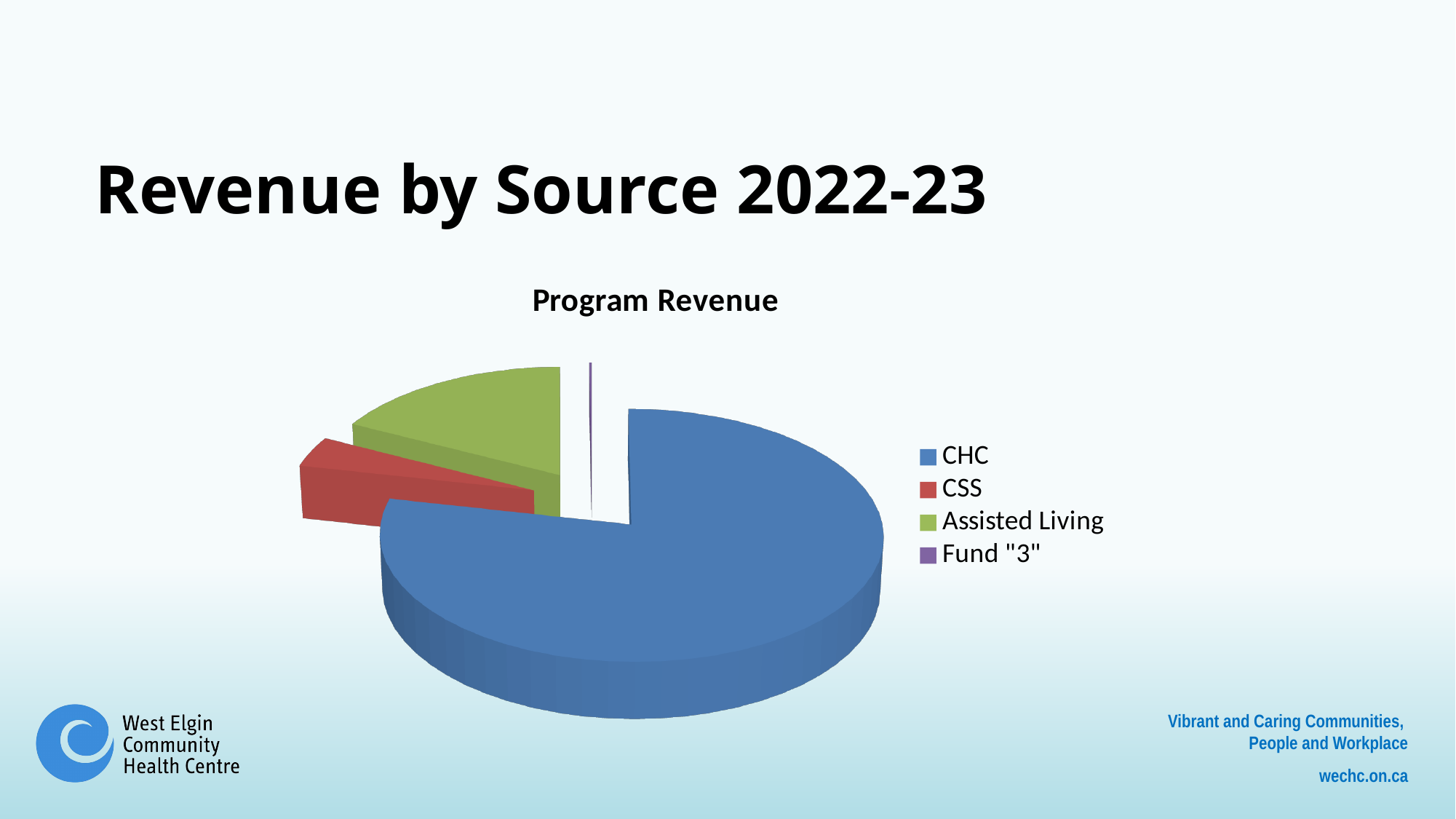
Which slice is larger, CSS or Assisted Living? Assisted Living What is the title of the chart? Program Revenue Which category has the largest slice of the pie? CHC Which category is shown in green? Assisted Living Which category has the smallest slice of the pie? Fund "3" How many categories does the pie chart show? 4 Which slice is larger, Fund "3" or CSS? CSS What colour is the CHC slice? blue What kind of chart is shown on the slide? pie chart Which slice is larger, CHC or CSS? CHC